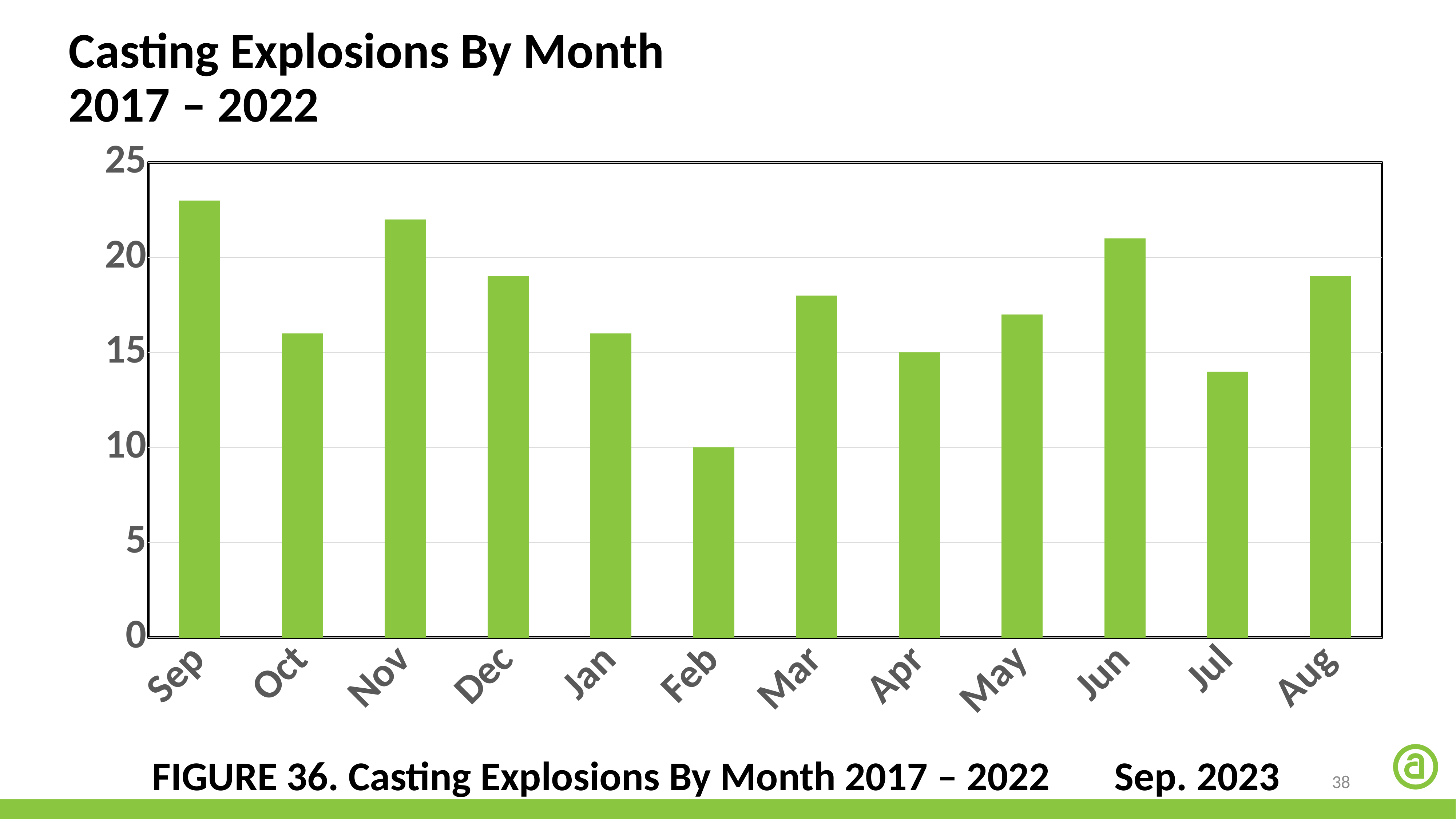
Which month has more casting explosions, Jul or Jun? Jun Is the value for Jul greater or less than 15? less Is the value for Jun greater or less than 20? greater Is the value for Dec greater or less than 20? less Which month has the highest number of casting explosions? Sep What kind of chart is shown on the slide? bar chart How many months are shown on the x axis of the chart? 12 What is the title of the chart? Casting Explosions By Month 2017 – 2022 Which month has more casting explosions, Nov or Oct? Nov Which month has the lowest number of casting explosions? Feb